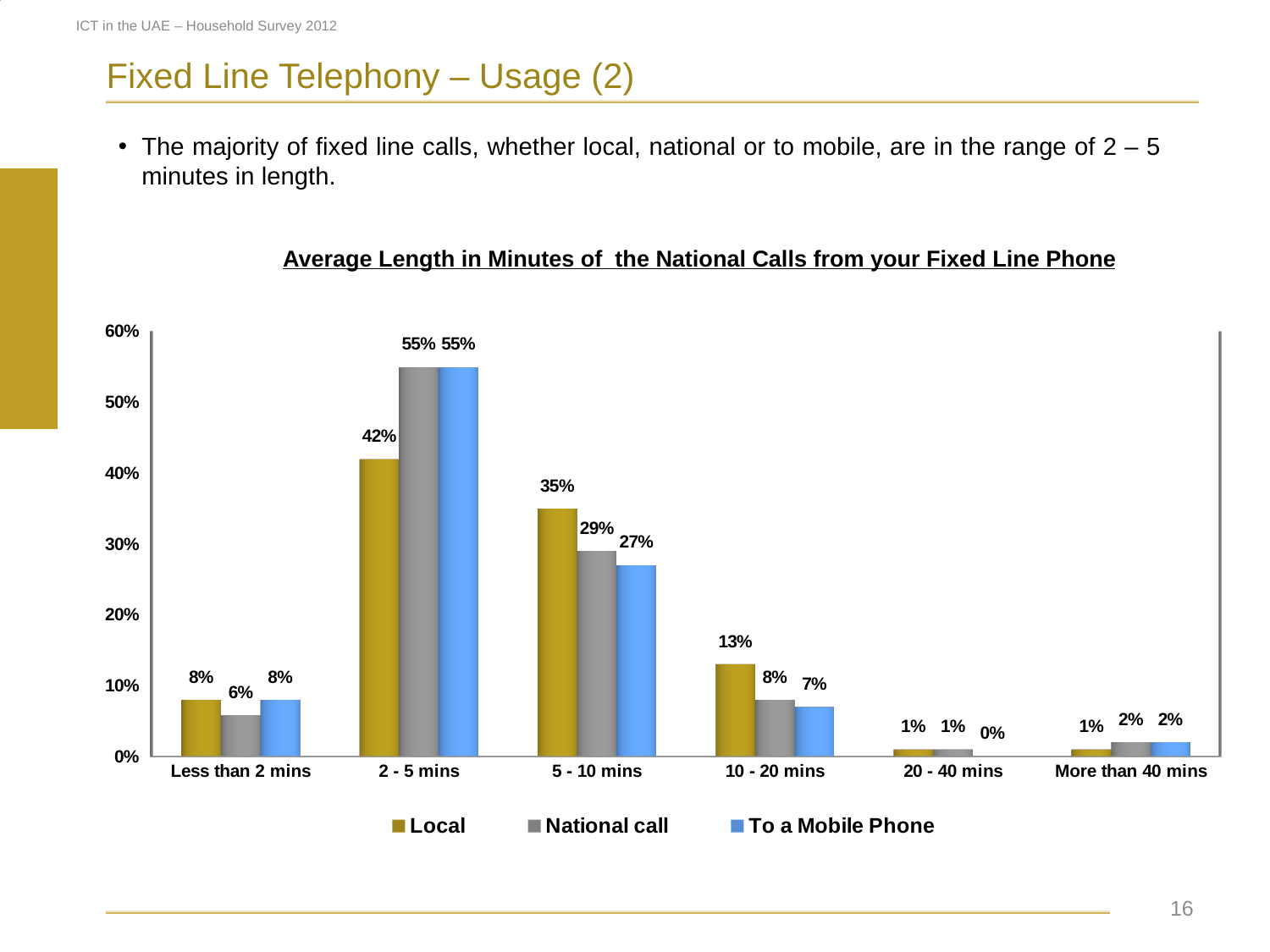
Which category has the lowest value for the To a Mobile Phone series? 20 - 40 mins What is the value for Local in the 2 - 5 mins category? 42% Which category has the highest value for the Local series? 2 - 5 mins What is the value for To a Mobile Phone in the 5 - 10 mins category? 27% How many categories are shown on the x axis? 6 What kind of chart is shown on the slide? bar chart What is the title of the chart? Average Length in Minutes of the National Calls from your Fixed Line Phone What is the difference between the Local and National call values in the 10 - 20 mins category? 5% What is the value for National call in the Less than 2 mins category? 6% How many series does the legend list? 3 Is the value for National call in the 2 - 5 mins category greater or less than 50%? greater In the 5 - 10 mins category, which is larger: Local or National call? Local